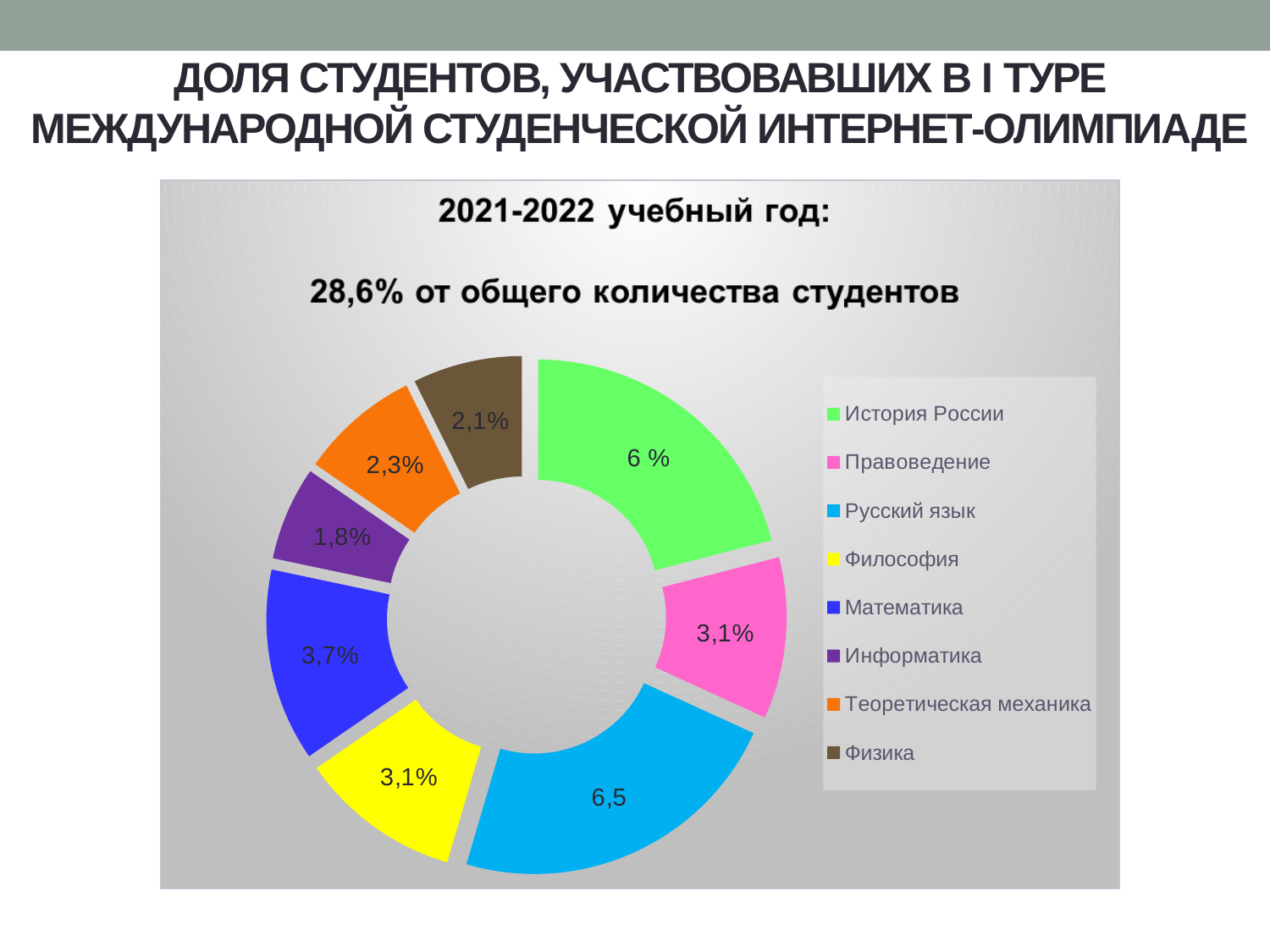
What is the difference between the values for Математика and Информатика? 1,9% What value is shown for Русский язык? 6,5 Which is larger, the value for Математика or the value for Физика? Математика What value is shown for История России? 6 % What value is shown for Математика? 3,7% Which category has the smallest value? Информатика What value is shown for Информатика? 1,8% How many categories does the legend list? 8 What kind of chart is shown on the slide? Doughnut (pie) chart What academic year does the chart title refer to? 2021-2022 учебный год What value is shown for Теоретическая механика? 2,3% Which category has the largest value? Русский язык